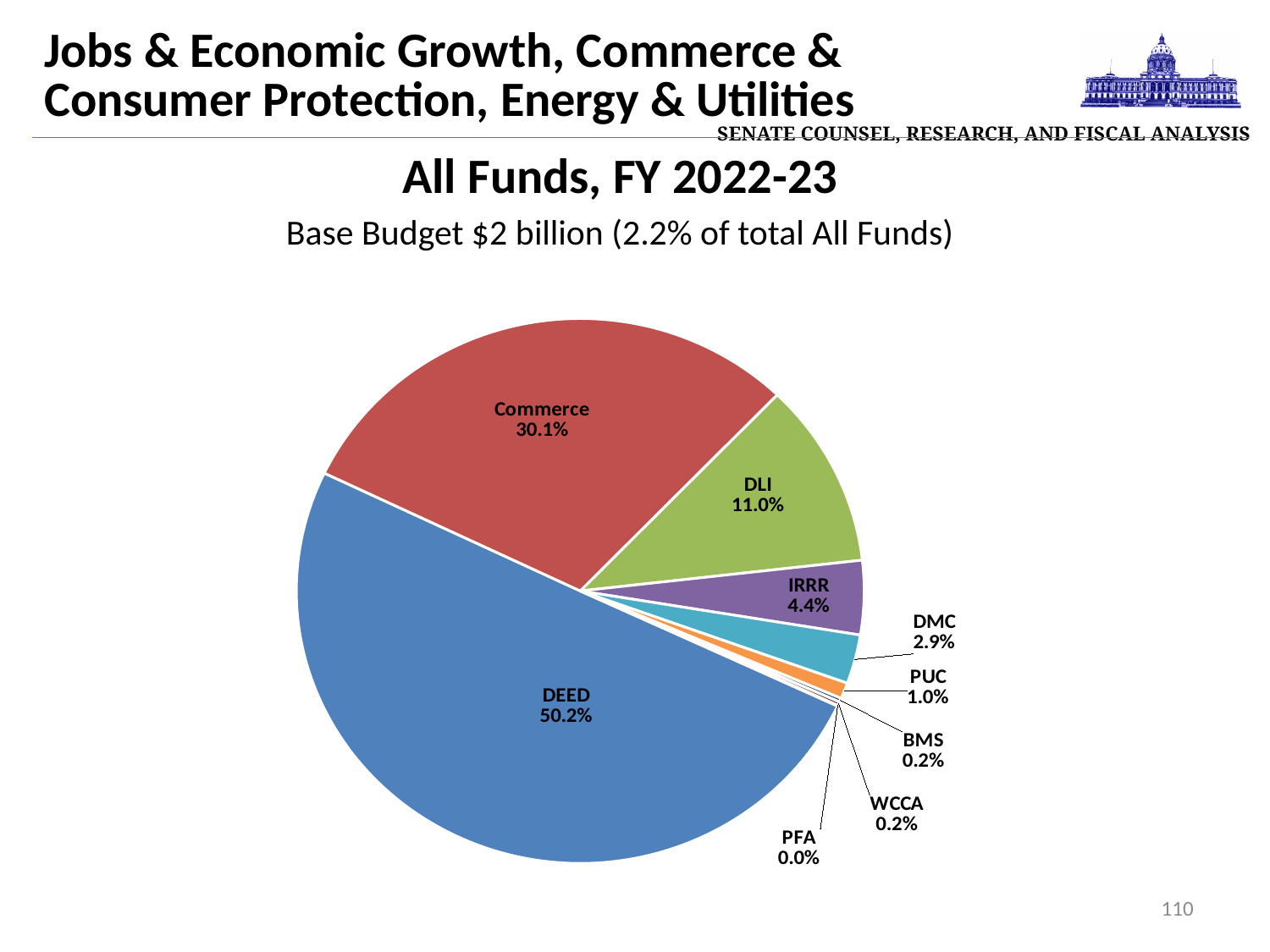
What is the value labelled for DLI? 11.0% What share of the pie does DEED account for? 50.2% Which category has the smallest labelled share? PFA What type of chart is shown on the slide? pie chart What is the difference in percentage points between DEED and Commerce? 20.1 Which category has the largest slice of the pie? DEED Which is larger, the share for DLI or the share for IRRR? DLI What percentage is shown for Commerce? 30.1% What is the title of the chart? All Funds, FY 2022-23 What share does DMC have? 2.9% What percentage is shown for IRRR? 4.4% How many categories are labelled on the pie chart? 9